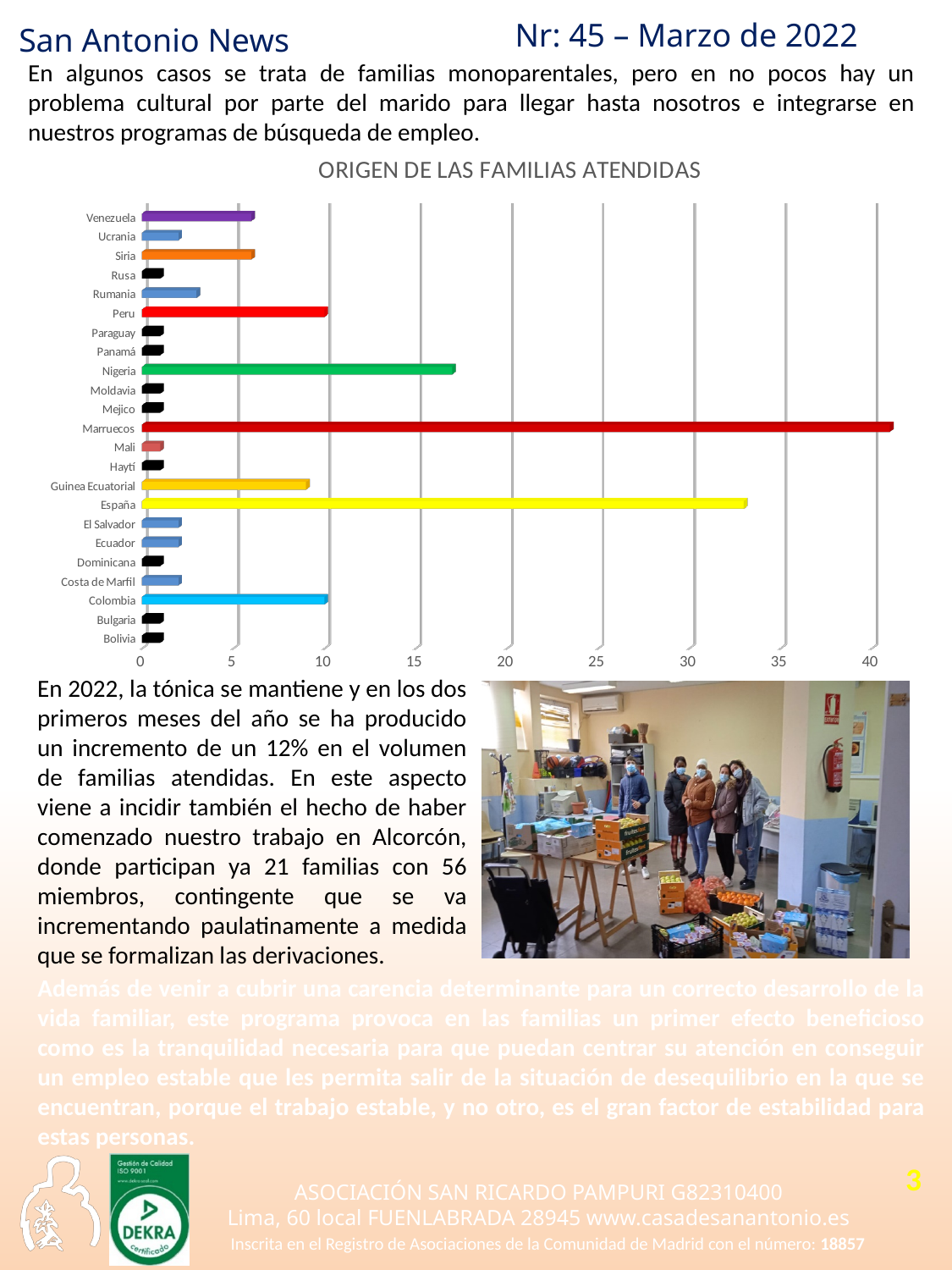
Which country has the highest value in the chart? Marruecos Which has a larger value, Marruecos or España? Marruecos Is the value for España greater or less than 30? greater Is the value for Nigeria greater or less than 15? greater Is the value for Marruecos greater or less than 40? greater What kind of chart is shown under the title 'ORIGEN DE LAS FAMILIAS ATENDIDAS'? Bar chart Which has a larger value, Nigeria or Guinea Ecuatorial? Nigeria What is the title of the chart? ORIGEN DE LAS FAMILIAS ATENDIDAS How many countries are listed as categories in the chart? 23